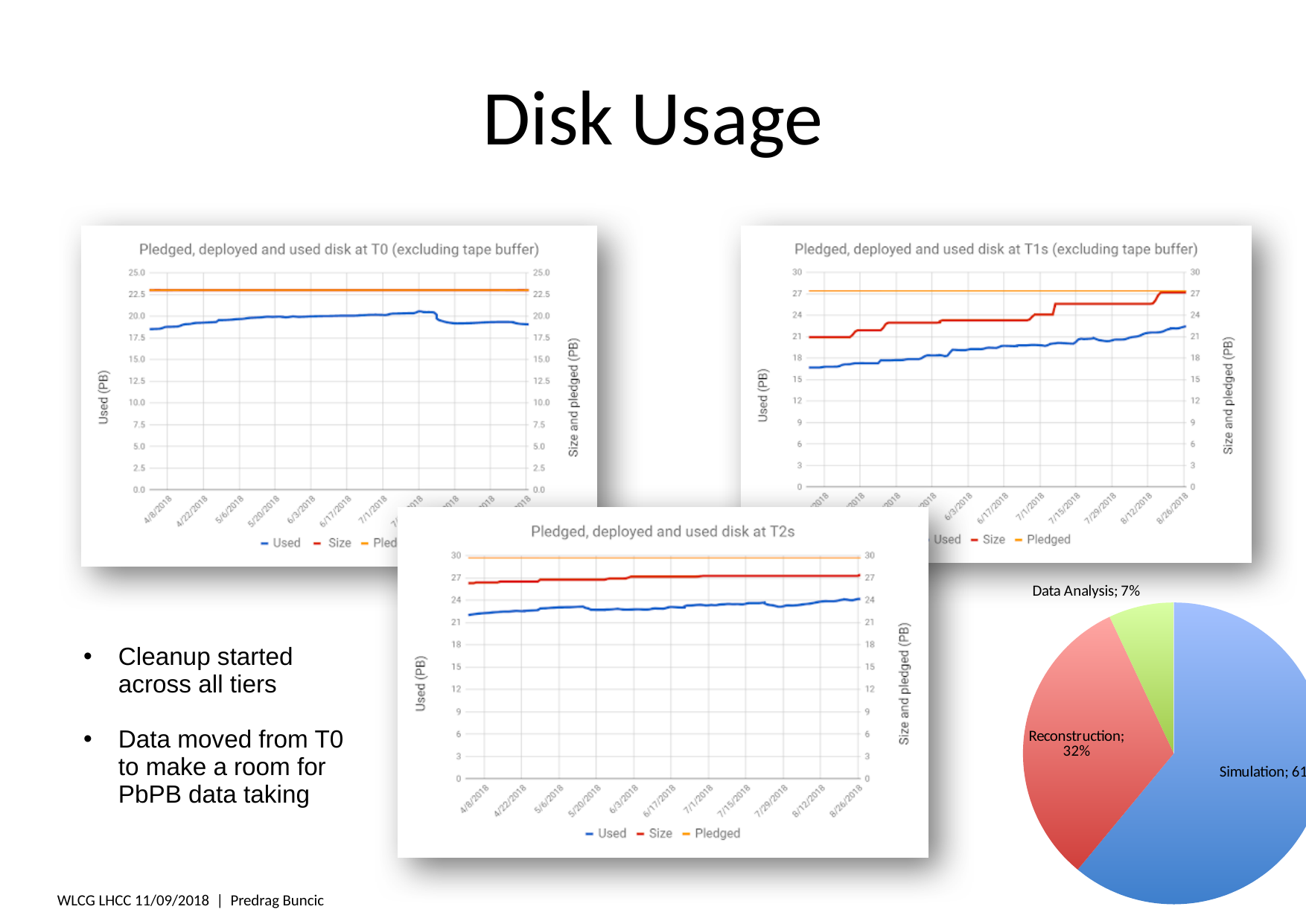
What kind of chart is 'Pledged, deployed and used disk at T0 (excluding tape buffer)'? line chart In 'Pledged, deployed and used disk at T2s', is the Used value at the end of the period greater or less than 21? greater In the pie chart on the right, what is the share for Data Analysis? 7% How many series does the legend of 'Pledged, deployed and used disk at T2s' list? 3 In the pie chart on the right, what is the share for Reconstruction? 32% How many slices does the pie chart on the right have? 3 In 'Pledged, deployed and used disk at T0 (excluding tape buffer)', is the Pledged value greater or less than 20.0? greater In the pie chart on the right, which category has the largest slice? Simulation In 'Pledged, deployed and used disk at T1s (excluding tape buffer)', which series is shown in orange? Pledged In the pie chart on the right, what is the difference between the Reconstruction share and the Data Analysis share? 25% In 'Pledged, deployed and used disk at T1s (excluding tape buffer)', does the Used line rise or fall over time? rise In the pie chart on the right, which category has the smallest slice? Data Analysis